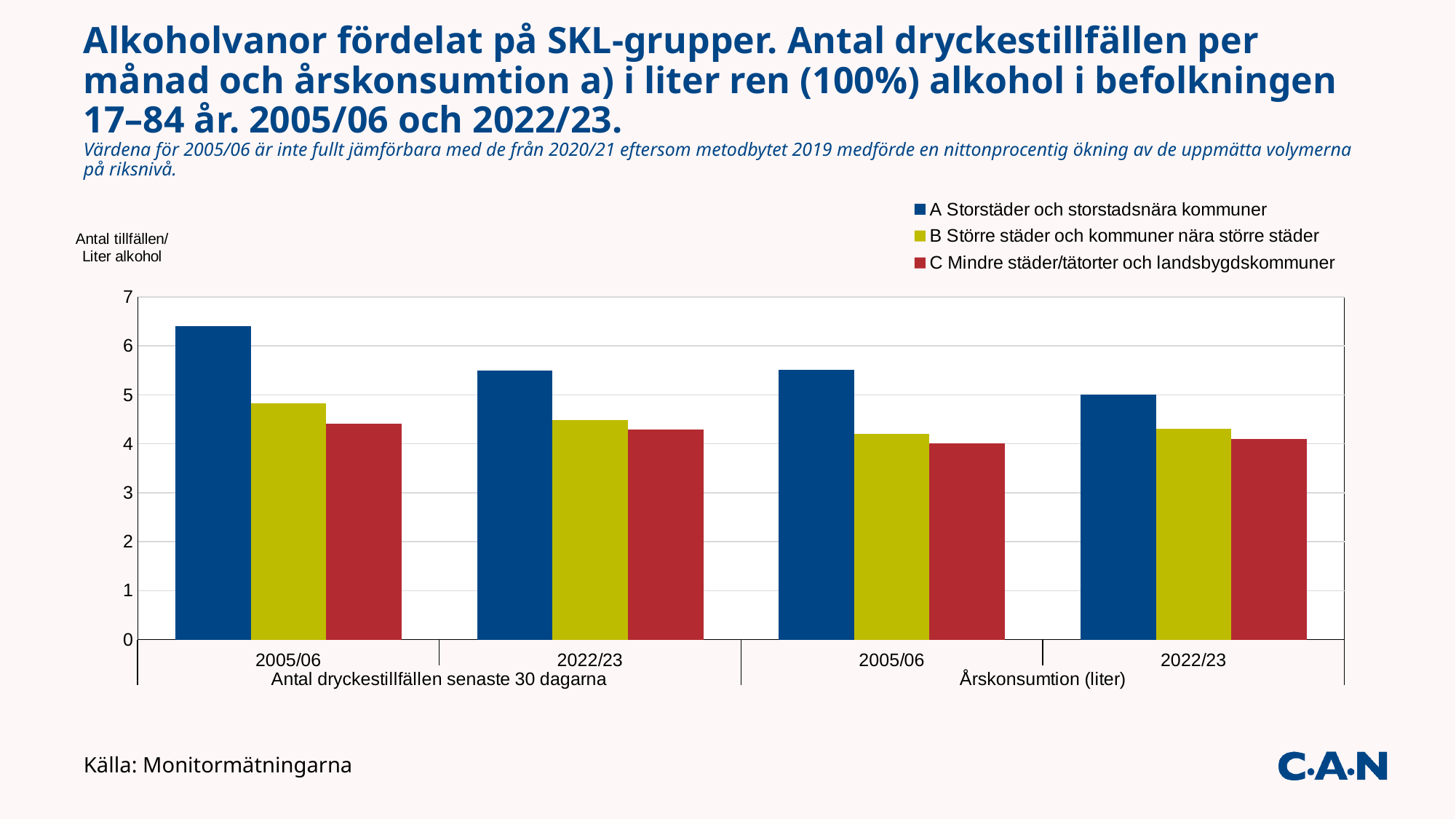
Is the value for A Storstäder och storstadsnära kommuner in 2022/23 under Årskonsumtion (liter) greater or less than 4? greater What kind of chart is shown on the slide? bar chart Under Antal dryckestillfällen senaste 30 dagarna, does the value for A Storstäder och storstadsnära kommuner rise or fall from 2005/06 to 2022/23? fall What colour represents C Mindre städer/tätorter och landsbygdskommuner in the chart? red What source is cited for the chart? Monitormätningarna How many groups of bars are plotted along the x axis? 4 Which series has the tallest bar in the whole chart? A Storstäder och storstadsnära kommuner In 2005/06 under Årskonsumtion (liter), which series has the lowest bar? C Mindre städer/tätorter och landsbygdskommuner How many series does the legend list? 3 In 2022/23 under Årskonsumtion (liter), which is larger: A Storstäder och storstadsnära kommuner or C Mindre städer/tätorter och landsbygdskommuner? A Storstäder och storstadsnära kommuner Is the value for B Större städer och kommuner nära större städer in 2005/06 under Antal dryckestillfällen senaste 30 dagarna greater or less than 5? less Is the value for A Storstäder och storstadsnära kommuner in 2005/06 under Antal dryckestillfällen senaste 30 dagarna greater or less than 6? greater